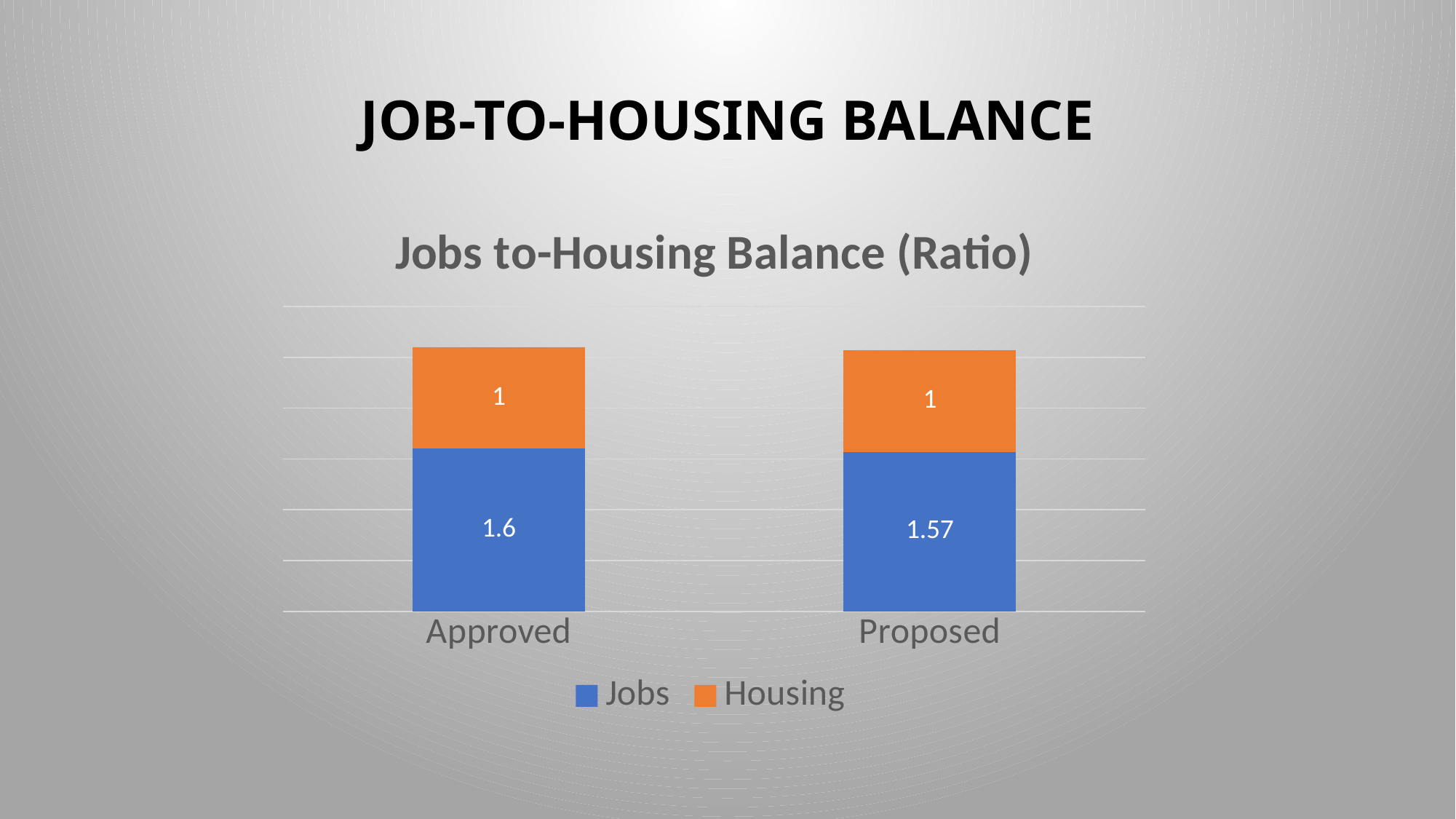
How many categories are shown on the x axis? 2 What is the title of the chart? Jobs to-Housing Balance (Ratio) What is the difference between the Jobs values for Approved and Proposed? 0.03 What is the Housing value for Approved? 1 What is the total of the stacked bar for Approved? 2.6 What is the Jobs value for Approved? 1.6 What is the total of the stacked bar for Proposed? 2.57 What is the Jobs value for Proposed? 1.57 Which colour represents the Housing series? Orange What kind of chart is shown? Stacked bar chart What is the Housing value for Proposed? 1 How many series does the legend list? 2